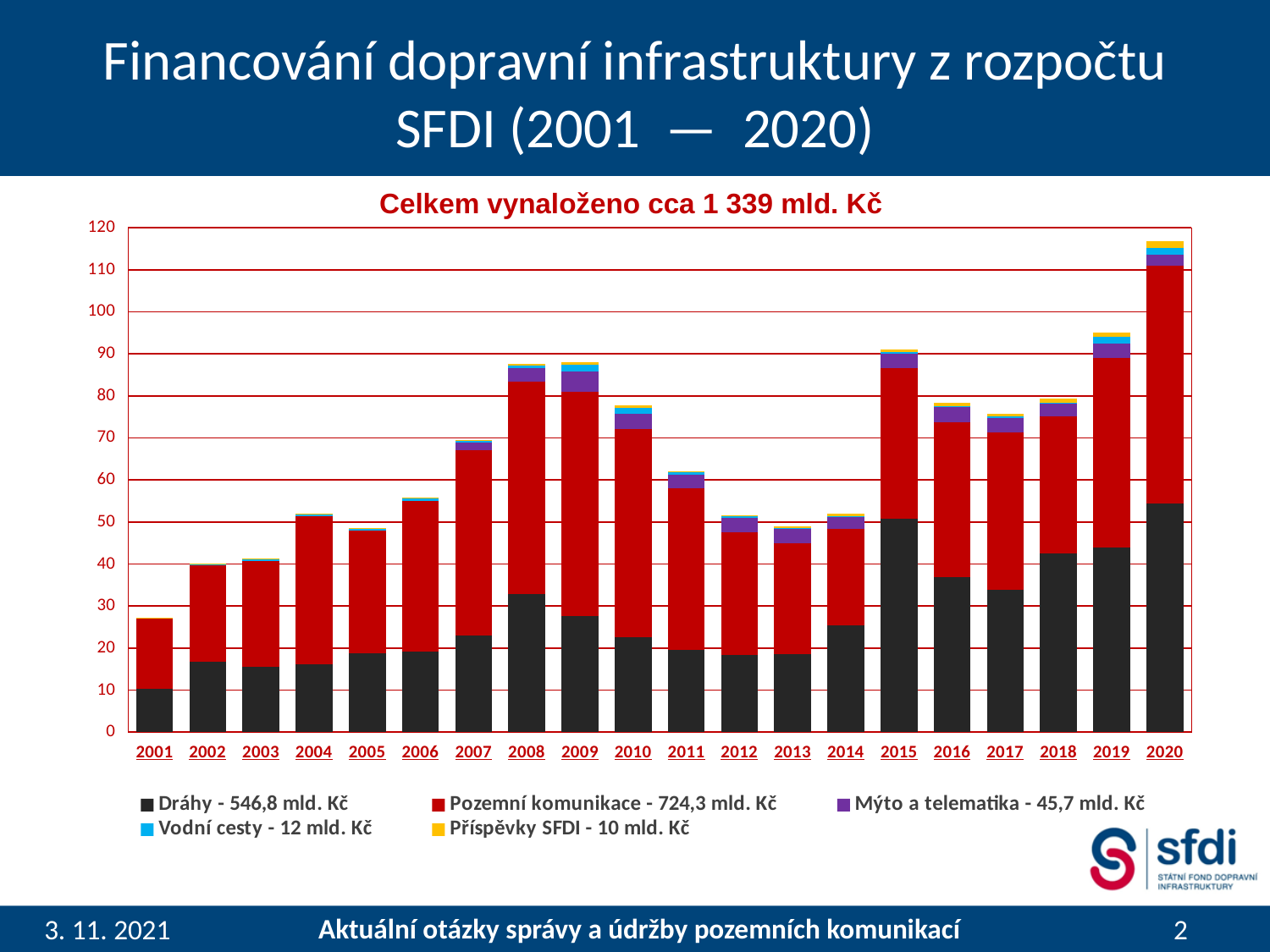
Is the total bar for 2020 greater or less than 110? greater How many years (categories) are shown on the x axis of the chart? 20 Is the total bar for 2001 greater or less than 30? less Is the total bar for 2012 greater or less than 60? less Which year has the larger total bar, 2018 or 2019? 2019 What kind of chart is shown on the slide? stacked bar chart What total amount is stated in the chart title above the bars? cca 1 339 mld. Kč How many series does the chart legend list? 5 Which year has the lowest total bar in the chart? 2001 Which year has the larger total bar, 2015 or 2016? 2015 Which year has the highest total bar in the chart? 2020